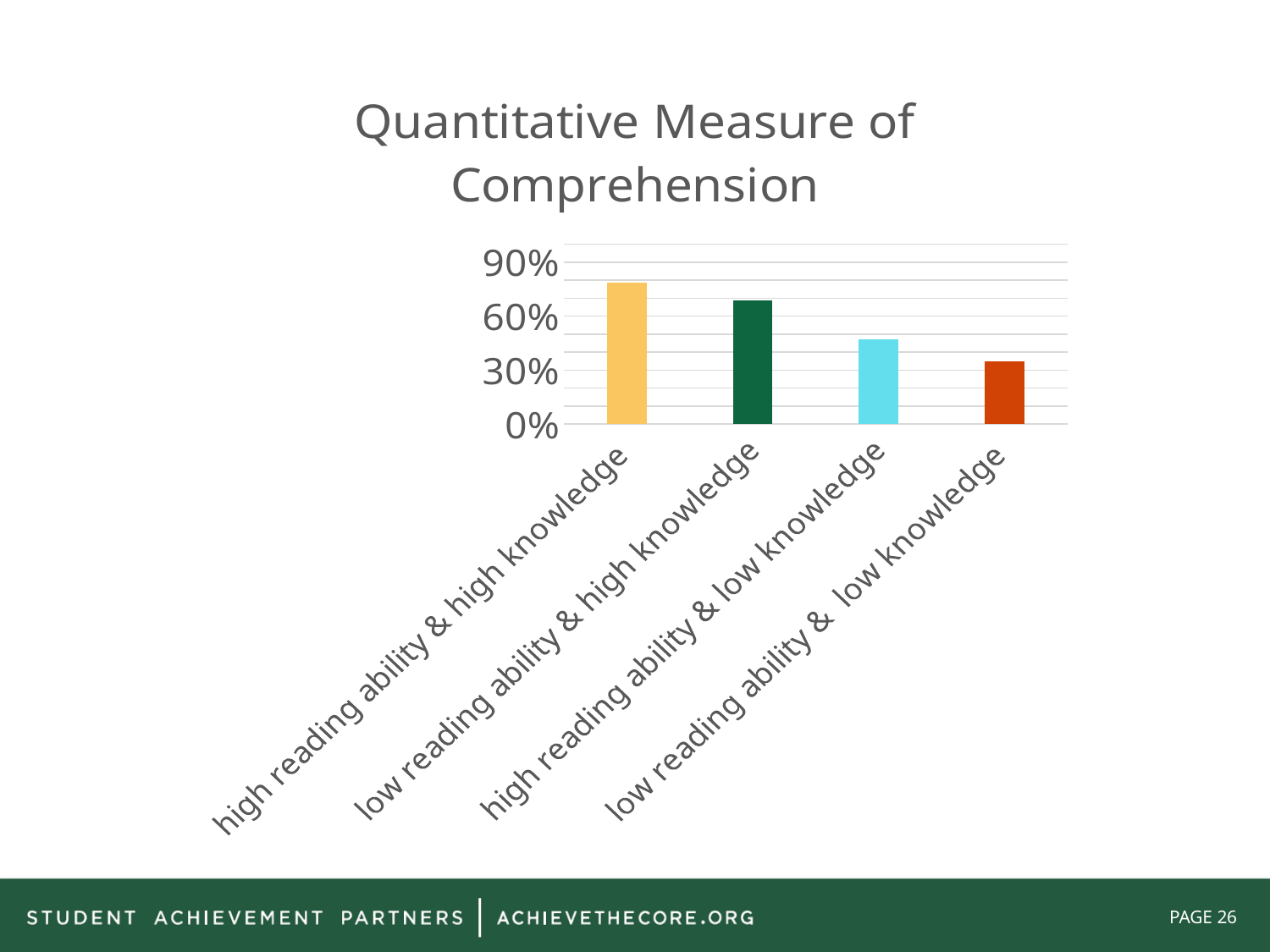
What is the title of the chart? Quantitative Measure of Comprehension Which is larger: the value for high reading ability & high knowledge or the value for low reading ability & high knowledge? high reading ability & high knowledge How many categories are plotted in the chart? 4 Which category has the highest value? high reading ability & high knowledge Is the value for low reading ability & low knowledge greater or less than 60%? less What kind of chart is shown on the slide? bar chart Is the value for high reading ability & high knowledge greater or less than 60%? greater Is the value for low reading ability & high knowledge greater or less than 60%? greater Which category has the lowest value? low reading ability & low knowledge Do the values rise or fall from left to right across the categories? fall